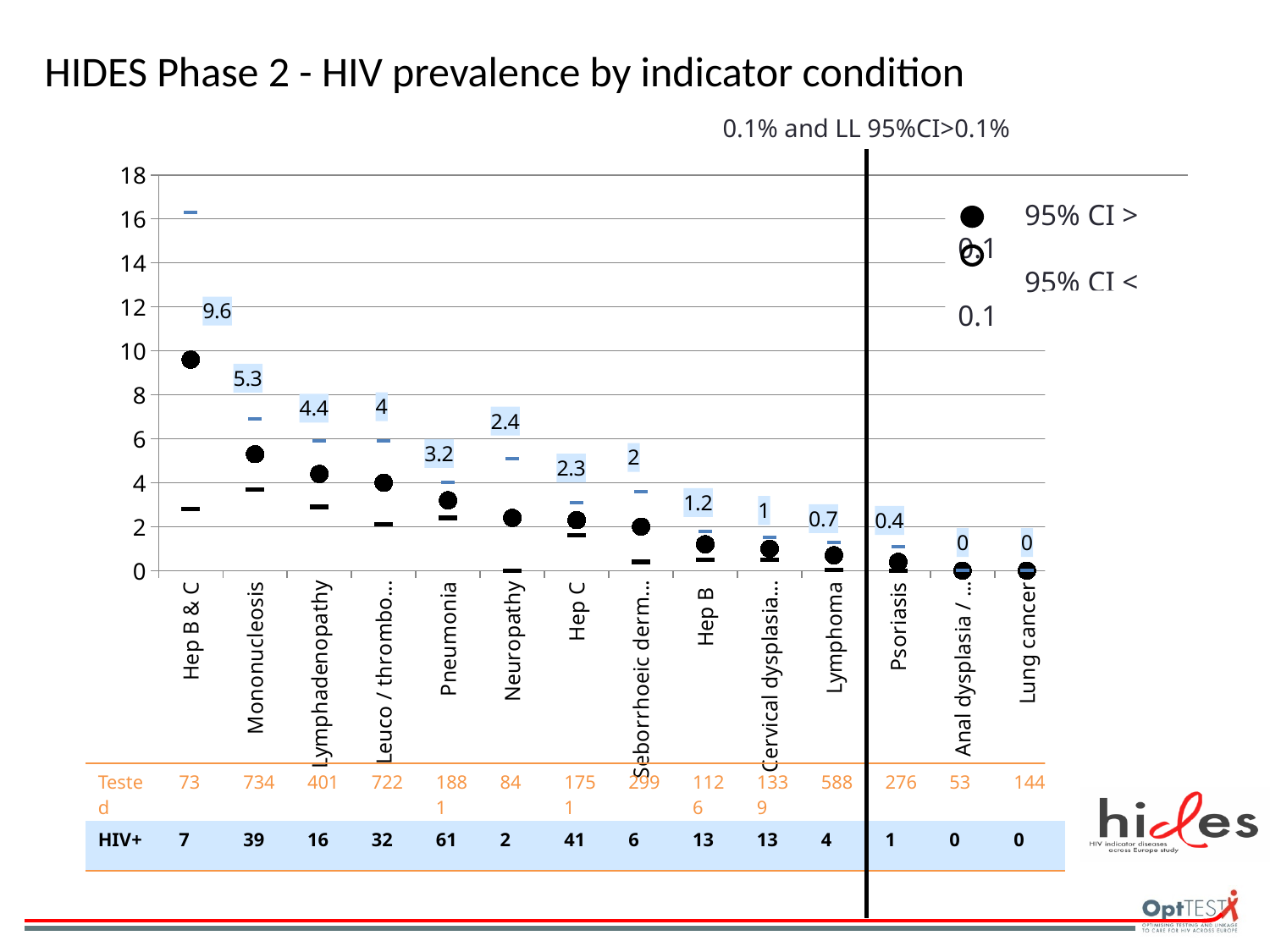
What kind of chart is used to show HIV prevalence by indicator condition? scatter chart What is the HIV prevalence value shown for Lymphoma? 0.7 Do the HIV prevalence values rise or fall from left to right along the x axis? fall What is the HIV prevalence value shown for Hep B & C? 9.6 Which has a higher HIV prevalence, Lymphadenopathy or Hep C? Lymphadenopathy What is the title of the slide's chart? HIDES Phase 2 - HIV prevalence by indicator condition How many HIV+ cases are listed for Pneumonia in the table below the chart? 61 What is the difference between the HIV prevalence for Hep B & C and for Mononucleosis? 4.3 How many people were tested for Mononucleosis according to the table below the chart? 734 What is the HIV prevalence value shown for Pneumonia? 3.2 How many indicator conditions are plotted on the x axis? 14 Which indicator condition has the highest HIV prevalence? Hep B & C